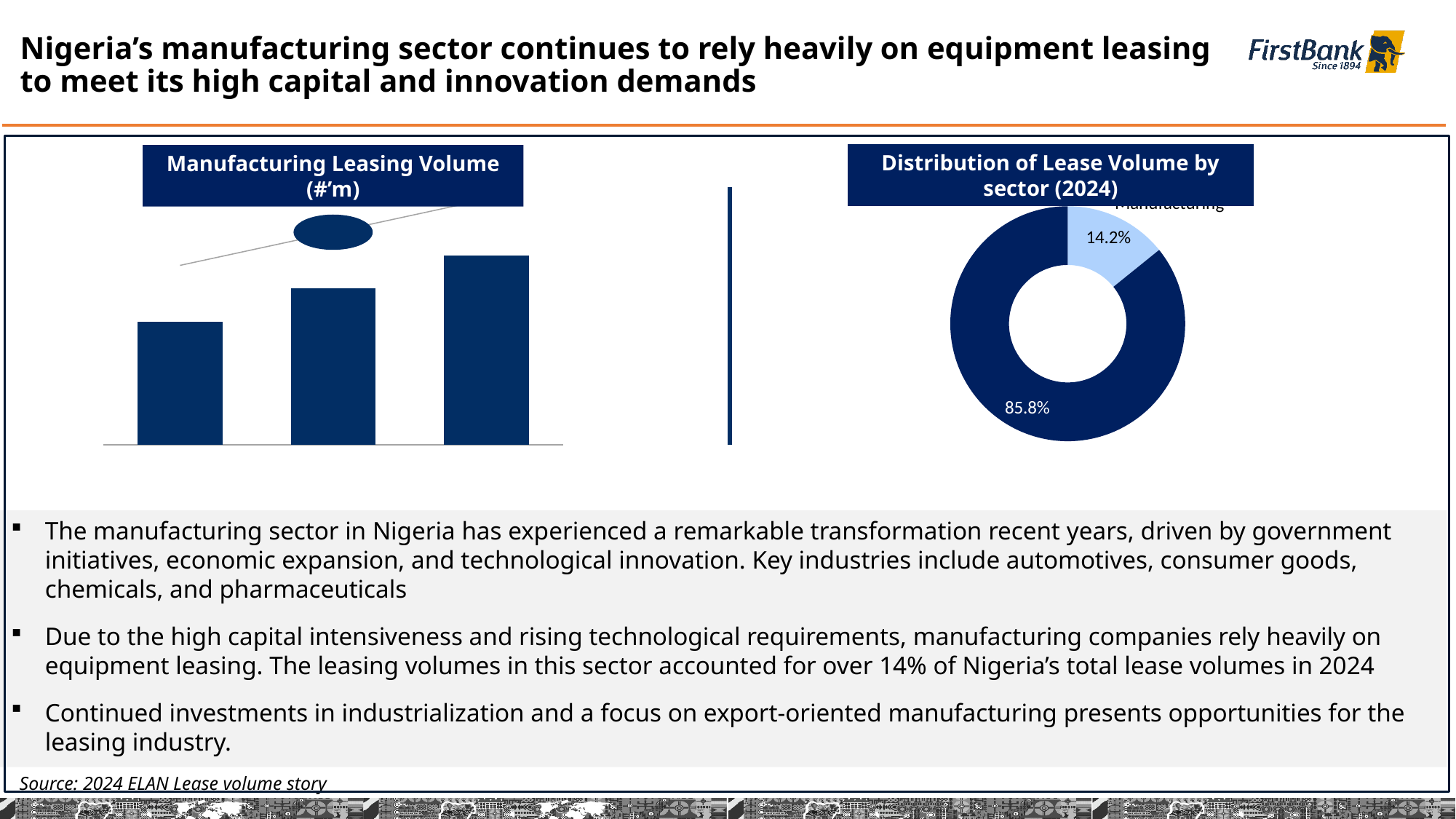
In the "Manufacturing Leasing Volume (#'m)" chart, which bar is the tallest: the left, middle or right one? Right In the "Distribution of Lease Volume by sector (2024)" chart, what is the difference in percentage points between the 85.8% slice and the 14.2% slice? 71.6 percentage points In the "Manufacturing Leasing Volume (#'m)" chart, do the bars rise or fall from left to right? Rise In the "Manufacturing Leasing Volume (#'m)" chart, which bar is the shortest: the left, middle or right one? Left In the "Distribution of Lease Volume by sector (2024)" chart, what share of lease volume is attributed to Manufacturing? 14.2% In the "Distribution of Lease Volume by sector (2024)" chart, how many slices does the donut have? 2 What kind of chart is the "Distribution of Lease Volume by sector (2024)" chart? Donut (pie) chart In the "Distribution of Lease Volume by sector (2024)" chart, which slice is larger: the Manufacturing slice or the other slice? The other slice What kind of chart is the "Manufacturing Leasing Volume (#'m)" chart? Bar chart In the "Distribution of Lease Volume by sector (2024)" chart, what is the value of the largest slice? 85.8% In the "Distribution of Lease Volume by sector (2024)" chart, what is the value of the smallest slice? 14.2% How many bars are plotted in the "Manufacturing Leasing Volume (#'m)" chart? 3